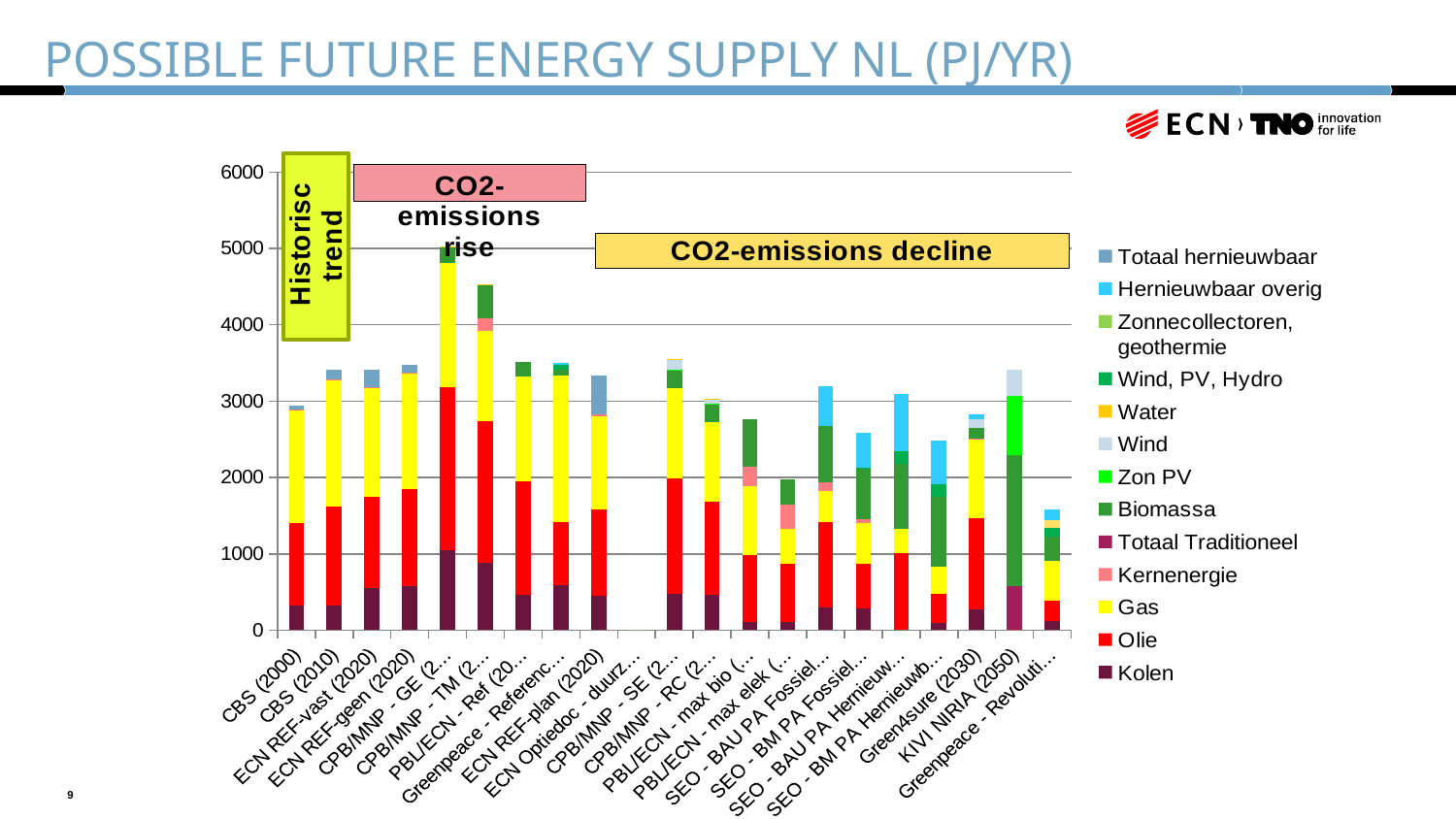
Is the total for Green4sure (2030) greater or less than 3000? less Is the total for ECN REF-plan (2020) greater or less than 3000? greater Which bar has the highest total energy supply? CPB/MNP - GE How many series does the legend list? 13 What kind of chart is shown on the slide? Stacked bar chart What is the title of the chart? POSSIBLE FUTURE ENERGY SUPPLY NL (PJ/YR) Does the total energy supply rise or fall from CBS (2000) to CBS (2010)? rise Which colour represents Gas in the legend? Yellow How many bars (scenarios) are plotted on the chart? 20 Is the total for CBS (2010) greater or less than 3000? greater Which has the larger total: CBS (2010) or Green4sure (2030)? CBS (2010)